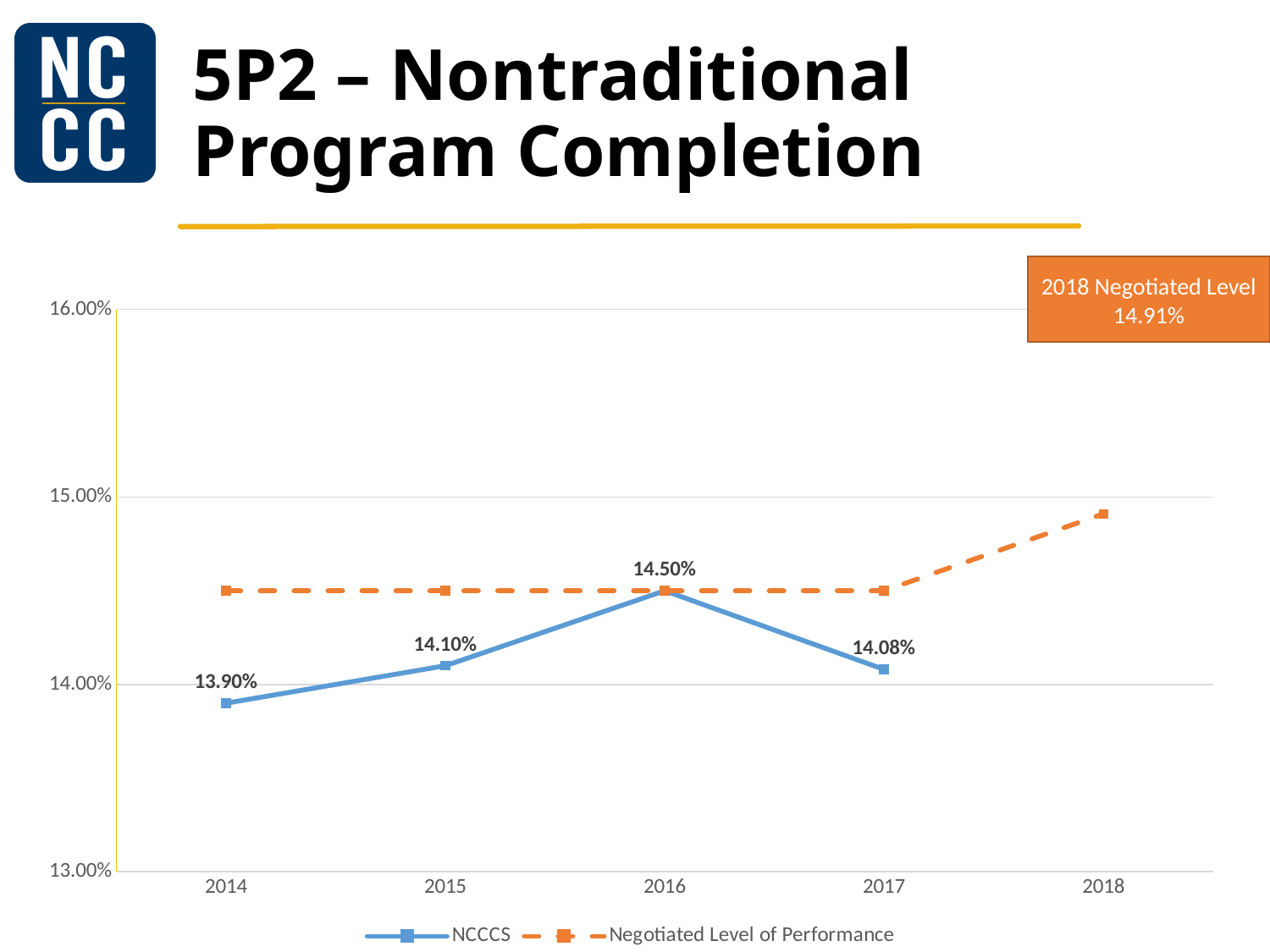
In which year is the NCCCS value highest? 2016 What is the NCCCS value for 2014? 13.90% How many series does the legend list? 2 What kind of chart is shown on the slide? line chart How many years are shown on the x axis? 5 What is the NCCCS value for 2016? 14.50% Does the NCCCS value rise or fall from 2016 to 2017? fall What is the 2018 Negotiated Level shown on the slide? 14.91% What is the difference between the NCCCS values for 2016 and 2014? 0.60% Is the Negotiated Level of Performance value for 2017 greater or less than 15.00%? less Which year has the larger NCCCS value, 2015 or 2017? 2015 In which year is the NCCCS value lowest? 2014